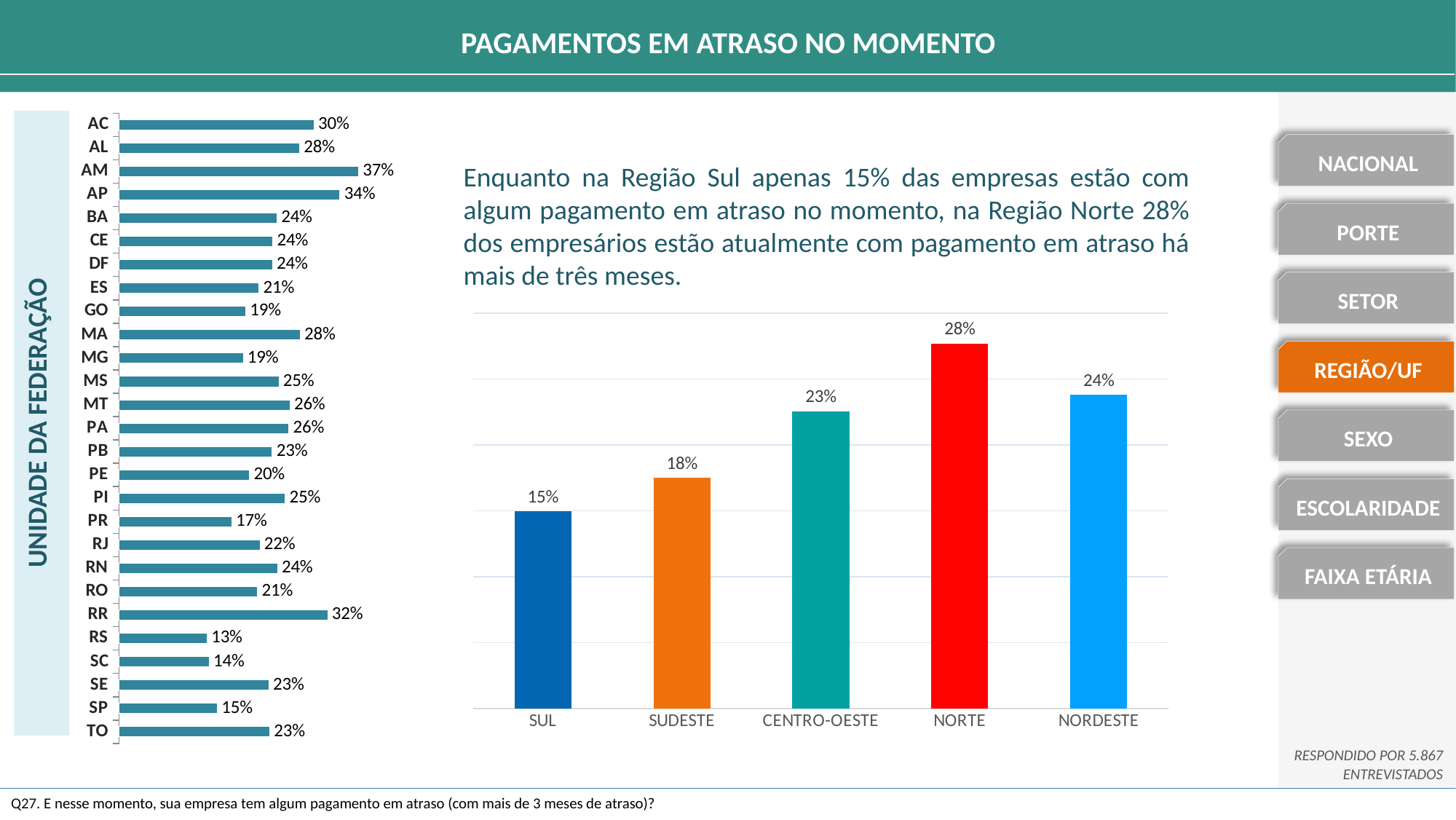
In the left chart by unidade da federação, what is the value for AM? 37% In the right chart by region, what is the value for CENTRO-OESTE? 23% In the left chart by unidade da federação, which state has the highest value? AM In the right chart by region, what is the difference between the values for NORTE and SUL? 13% In the left chart by unidade da federação, what is the value for SC? 14% In the right chart by region, which region has the highest value? NORTE In the left chart by unidade da federação, what is the difference between the values for RR and SP? 17% What kind of chart is the right chart by region? Bar chart In the left chart by unidade da federação, how many states are shown? 27 In the right chart by region, which region has the lowest value? SUL In the left chart by unidade da federação, which is larger, the value for AP or the value for AC? AP In the left chart by unidade da federação, which state has the lowest value? RS